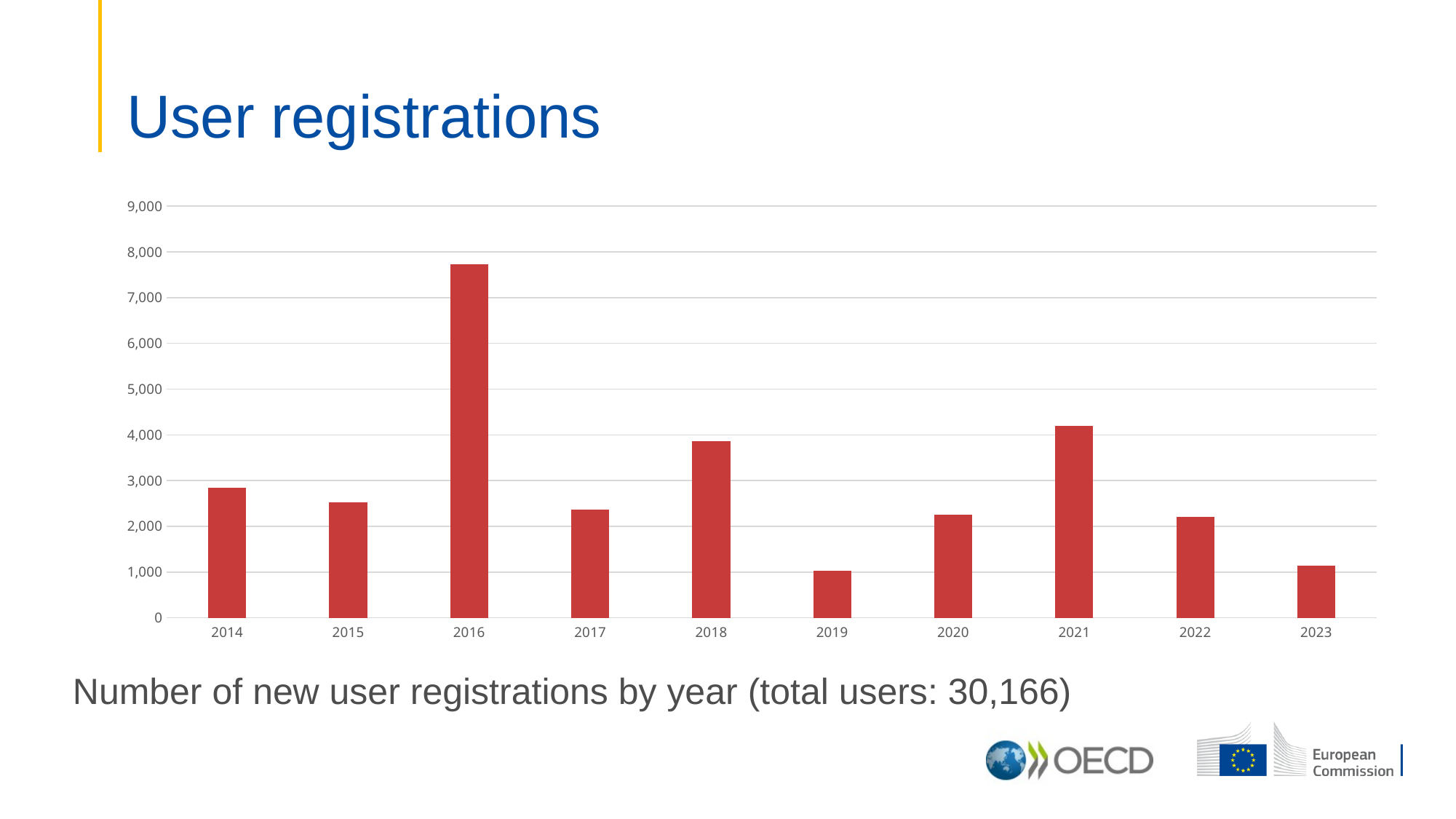
Is the value for 2023 greater or less than 2,000? less According to the caption below the chart, what is the total number of users? 30,166 Is the value for 2021 greater or less than 4,000? greater Is the value for 2020 greater or less than 2,000? greater Which year has more new user registrations, 2016 or 2021? 2016 How many years are shown on the x axis of the chart? 10 Do the values rise or fall from 2021 to 2023? fall Which year has more new user registrations, 2018 or 2014? 2018 What kind of chart is shown on the slide? bar chart Which year has the highest number of new user registrations? 2016